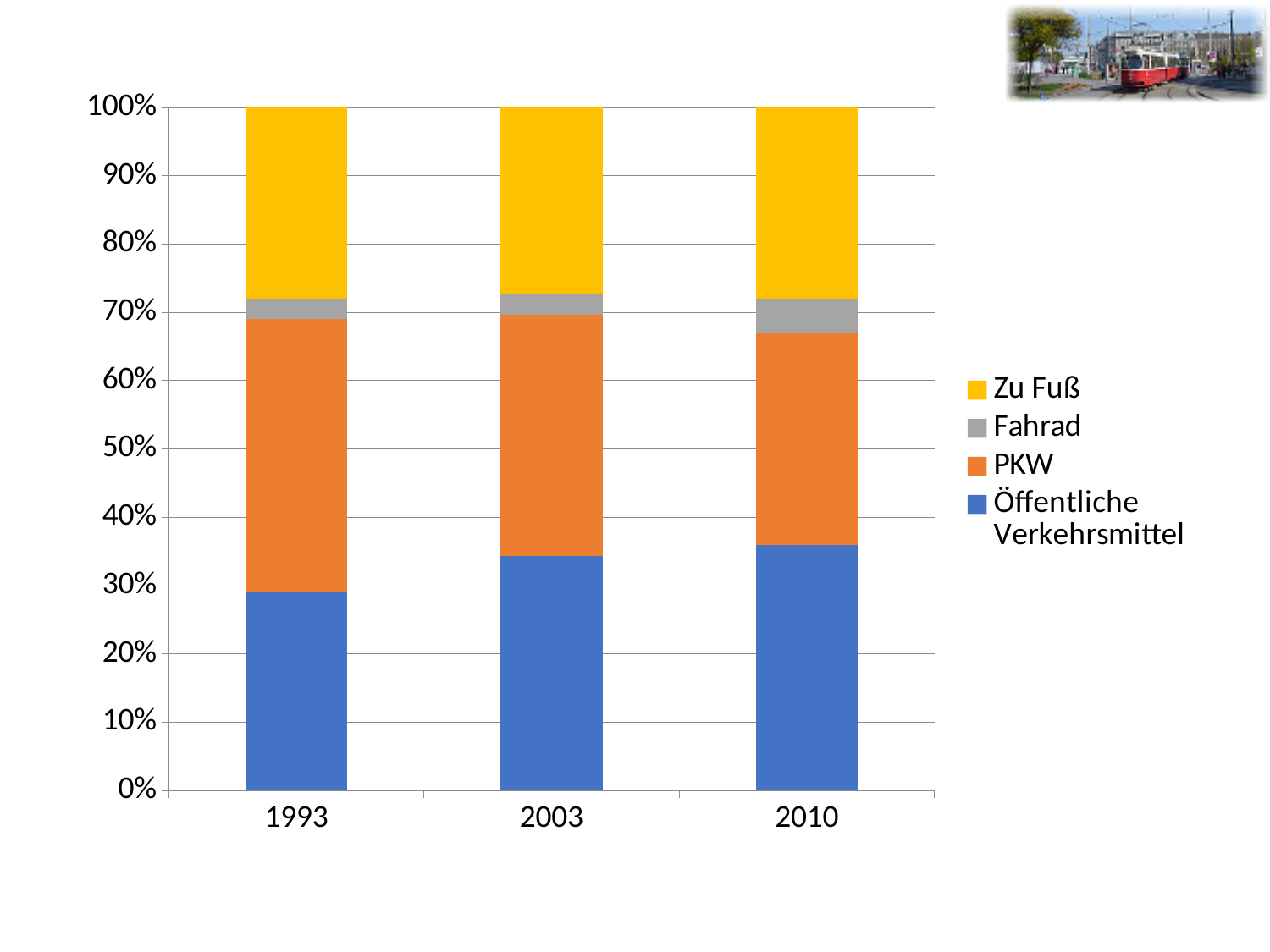
What kind of chart is shown on the slide? Stacked bar chart In which year is the share of Öffentliche Verkehrsmittel highest? 2010 Does the share of Öffentliche Verkehrsmittel rise or fall from 1993 to 2010? rise How many series does the legend of the chart list? 4 Which series forms the bottom segment of each stacked bar? Öffentliche Verkehrsmittel Which is larger, the PKW share in 1993 or the PKW share in 2010? 1993 In which year is the share of Öffentliche Verkehrsmittel lowest? 1993 How many years are shown on the x axis of the chart? 3 Is the share of Öffentliche Verkehrsmittel in 2010 greater or less than 30%? greater Does the share of PKW rise or fall from 1993 to 2010? fall Which series is shown in yellow in the chart? Zu Fuß